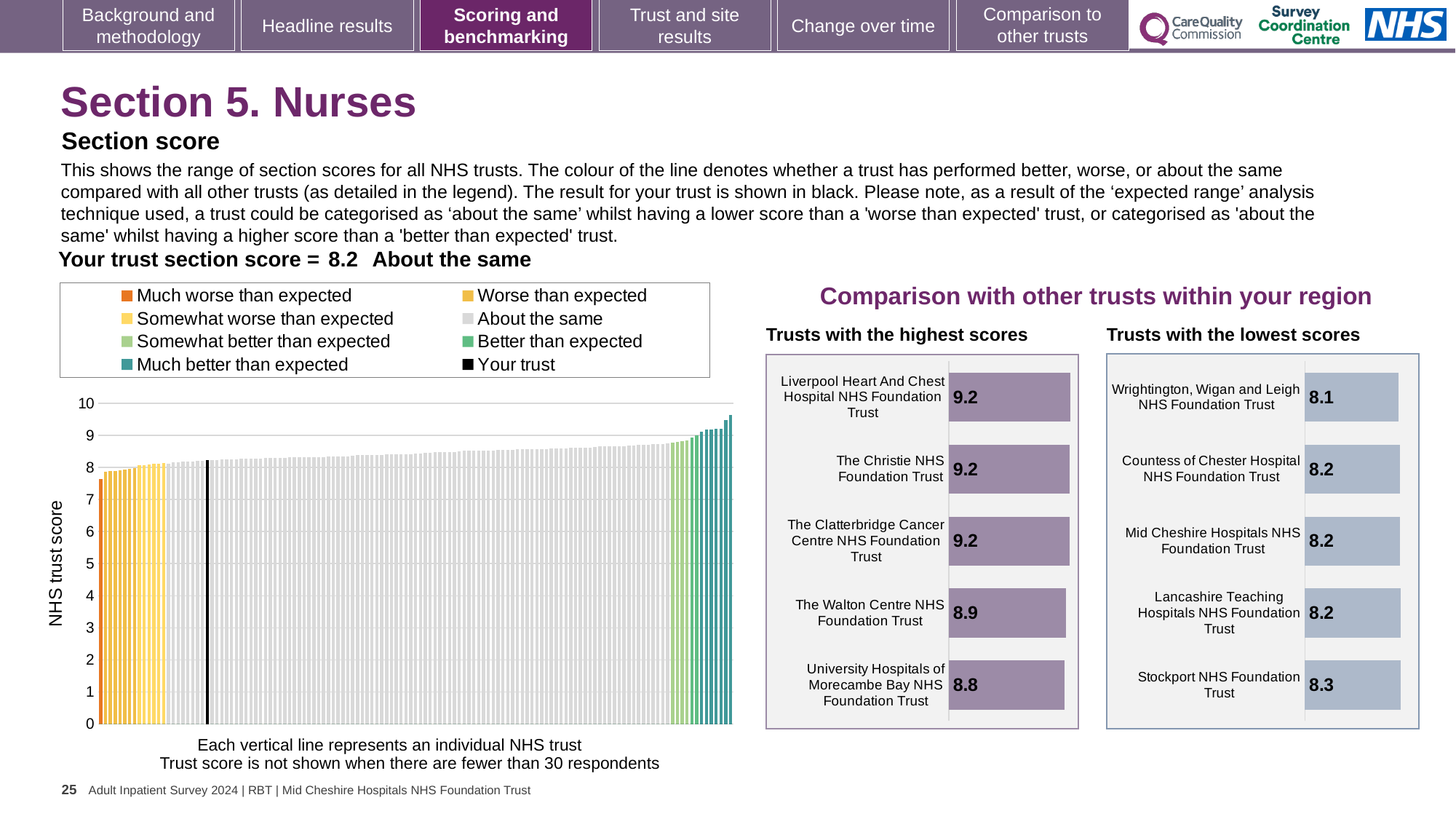
In the 'Trusts with the highest scores' chart, what is the score for The Walton Centre NHS Foundation Trust? 8.9 What kind of chart is the large chart on the left showing NHS trust scores? Bar chart In the 'Trusts with the highest scores' chart, how many trusts are shown? 5 In the 'Trusts with the lowest scores' chart, which has the larger score: Stockport NHS Foundation Trust or Mid Cheshire Hospitals NHS Foundation Trust? Stockport NHS Foundation Trust In the 'Trusts with the lowest scores' chart, what is the score for Wrightington, Wigan and Leigh NHS Foundation Trust? 8.1 In the 'Trusts with the highest scores' chart, which trust has the lowest score? University Hospitals of Morecambe Bay NHS Foundation Trust In the 'Trusts with the lowest scores' chart, which trust has the highest score? Stockport NHS Foundation Trust In the 'Trusts with the highest scores' chart, what is the difference between the scores of Liverpool Heart And Chest Hospital NHS Foundation Trust and University Hospitals of Morecambe Bay NHS Foundation Trust? 0.4 How many entries does the legend of the large chart on the left list? 8 In the 'Trusts with the highest scores' chart, what is the score for University Hospitals of Morecambe Bay NHS Foundation Trust? 8.8 In the 'Trusts with the lowest scores' chart, what is the difference between the scores of Stockport NHS Foundation Trust and Wrightington, Wigan and Leigh NHS Foundation Trust? 0.2 In the 'Trusts with the lowest scores' chart, which trust has the lowest score? Wrightington, Wigan and Leigh NHS Foundation Trust